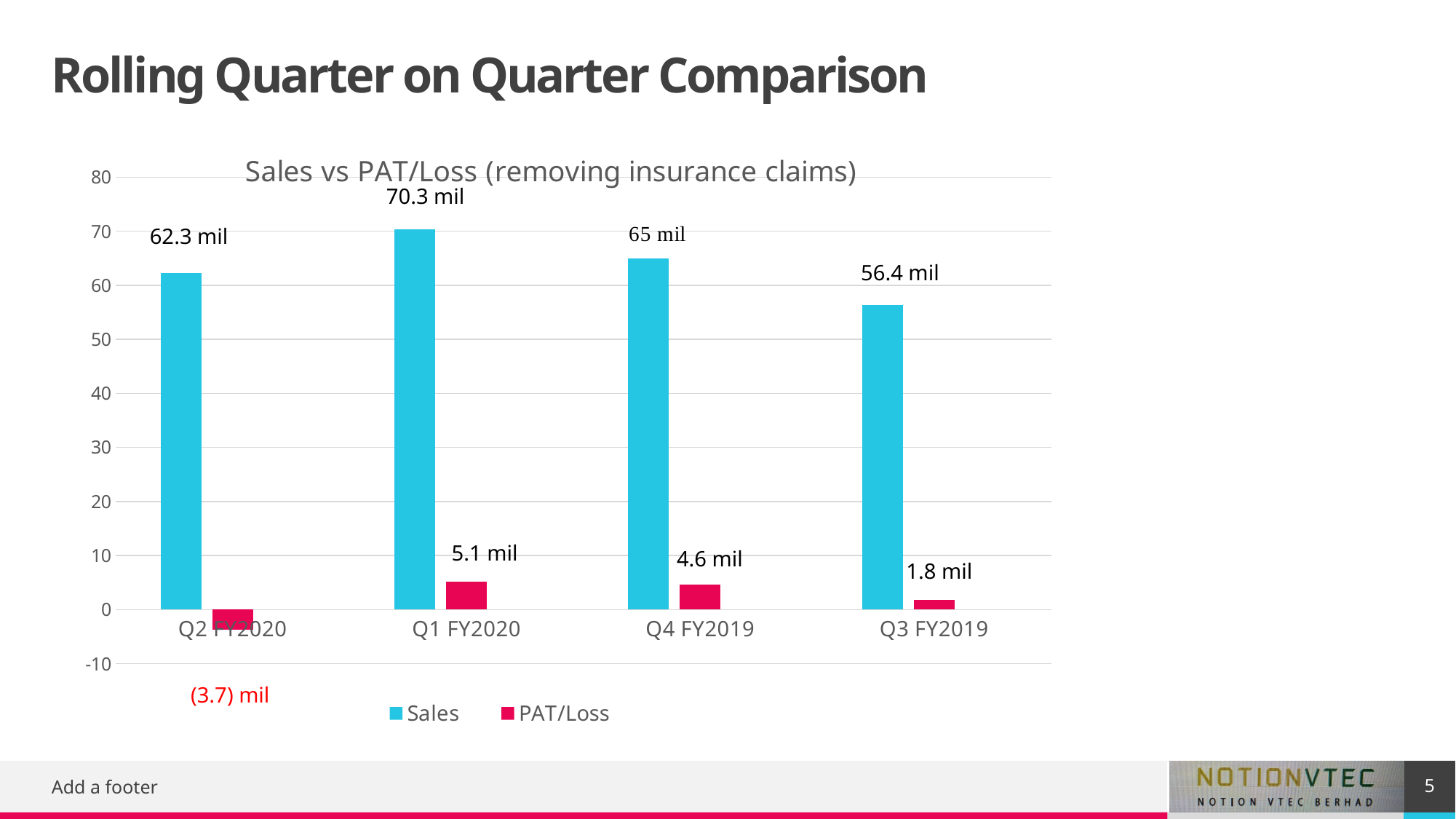
What is the Sales value for Q1 FY2020? 70.3 mil What is the difference in Sales between Q1 FY2020 and Q3 FY2019? 13.9 mil What is the PAT/Loss value for Q4 FY2019? 4.6 mil Which quarter has the lowest Sales? Q3 FY2019 How many series does the legend list? 2 What is the PAT/Loss value for Q2 FY2020? (3.7) mil Which quarter has the highest Sales? Q1 FY2020 How many quarters are shown on the x axis? 4 Is the Sales value for Q3 FY2019 greater or less than 60? less What is the title of the chart? Sales vs PAT/Loss (removing insurance claims) Which is larger, the Sales for Q2 FY2020 or the Sales for Q4 FY2019? Q4 FY2019 Which quarter has the highest PAT/Loss? Q1 FY2020